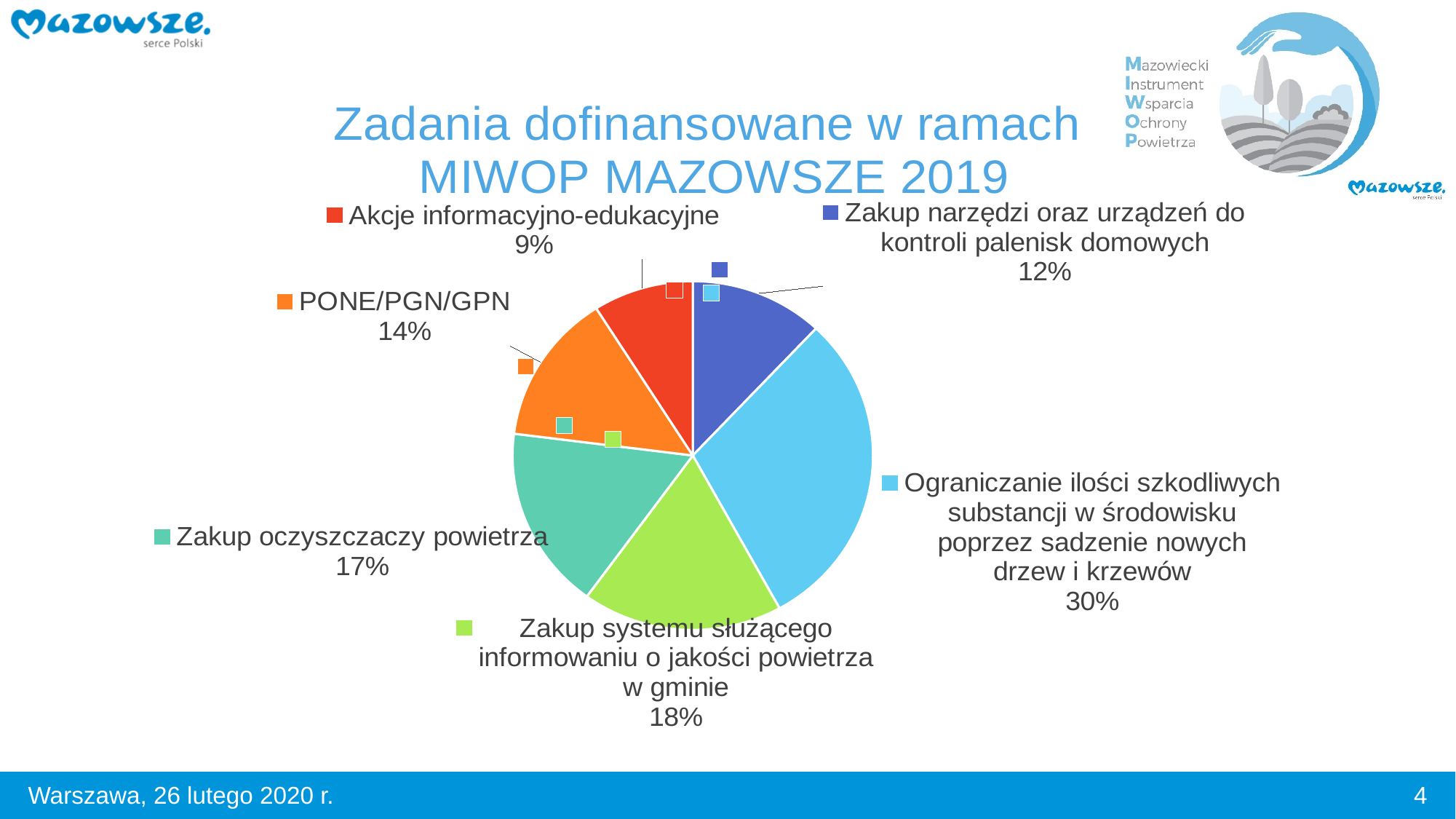
What kind of chart is shown on the slide? Pie chart What percentage is shown for "Zakup oczyszczaczy powietrza"? 17% What is the title of the chart on the slide? Zadania dofinansowane w ramach MIWOP MAZOWSZE 2019 What share of the pie is labelled "PONE/PGN/GPN"? 14% What is the difference in percentage points between "Ograniczanie ilości szkodliwych substancji w środowisku poprzez sadzenie nowych drzew i krzewów" and "Zakup narzędzi oraz urządzeń do kontroli palenisk domowych"? 18 Which category has the smallest share of the pie? Akcje informacyjno-edukacyjne How many slices does the pie chart have? 6 What colour is the slice for "Zakup oczyszczaczy powietrza"? Teal (green-blue) Which has a larger share: "PONE/PGN/GPN" or "Zakup narzędzi oraz urządzeń do kontroli palenisk domowych"? PONE/PGN/GPN What percentage is shown for "Zakup systemu służącego informowaniu o jakości powietrza w gminie"? 18% What percentage is shown for "Akcje informacyjno-edukacyjne"? 9% Which category has the largest share of the pie? Ograniczanie ilości szkodliwych substancji w środowisku poprzez sadzenie nowych drzew i krzewów